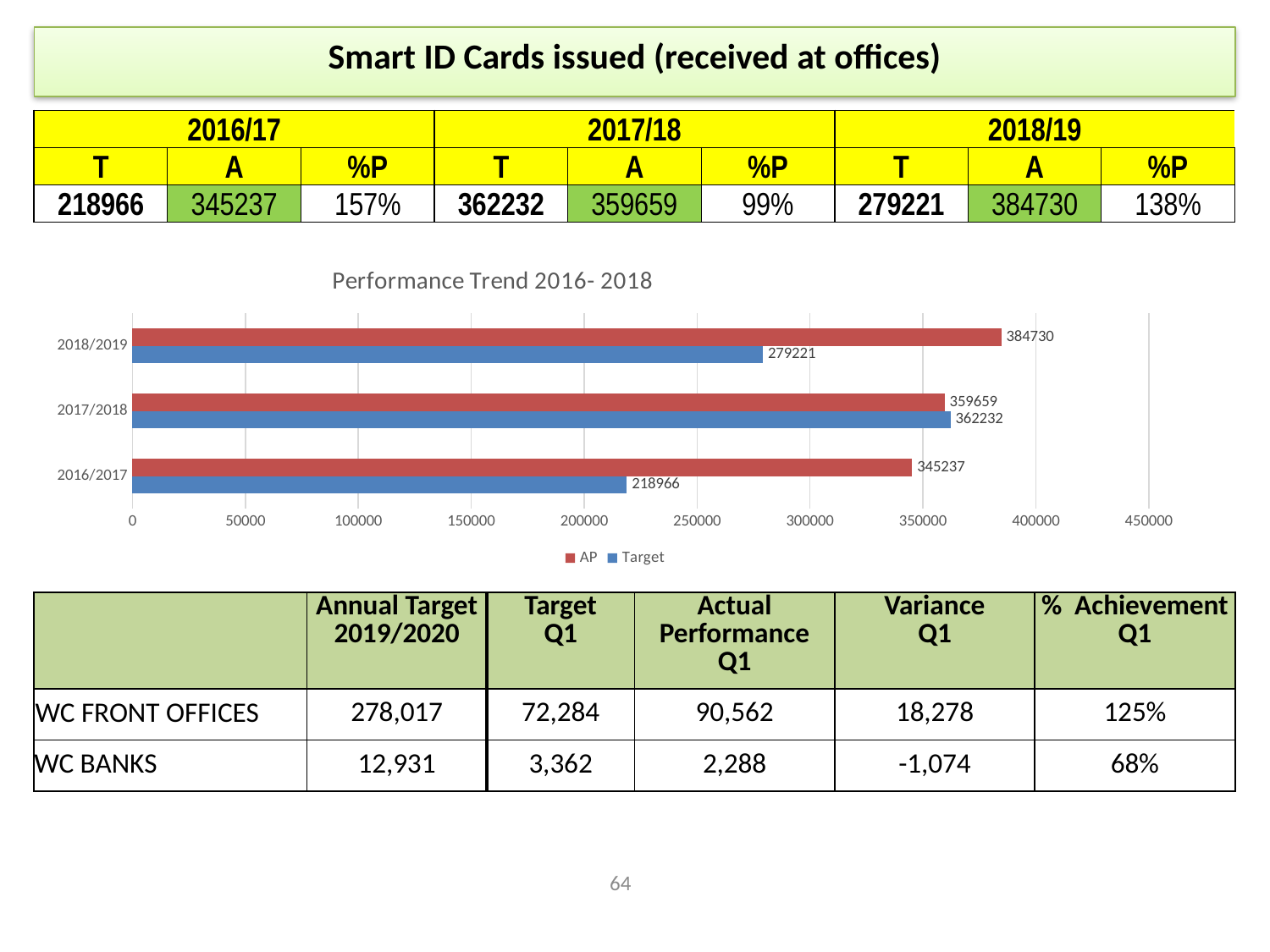
Which year has the lowest Target value in the chart? 2016/2017 How many series does the chart legend list? 2 What is the title of the chart? Performance Trend 2016- 2018 What type of chart is shown on the slide? bar chart What is the difference between the AP and Target values for 2018/2019? 105509 What is the AP value for 2018/2019 in the chart? 384730 What is the Target value for 2017/2018 in the chart? 362232 What is the Target value for 2016/2017 in the chart? 218966 Which year has the highest AP value in the chart? 2018/2019 How many year categories are shown on the chart's vertical axis? 3 Do the AP values rise or fall from 2016/2017 to 2018/2019? rise For 2016/2017, which is larger, the AP value or the Target value? AP